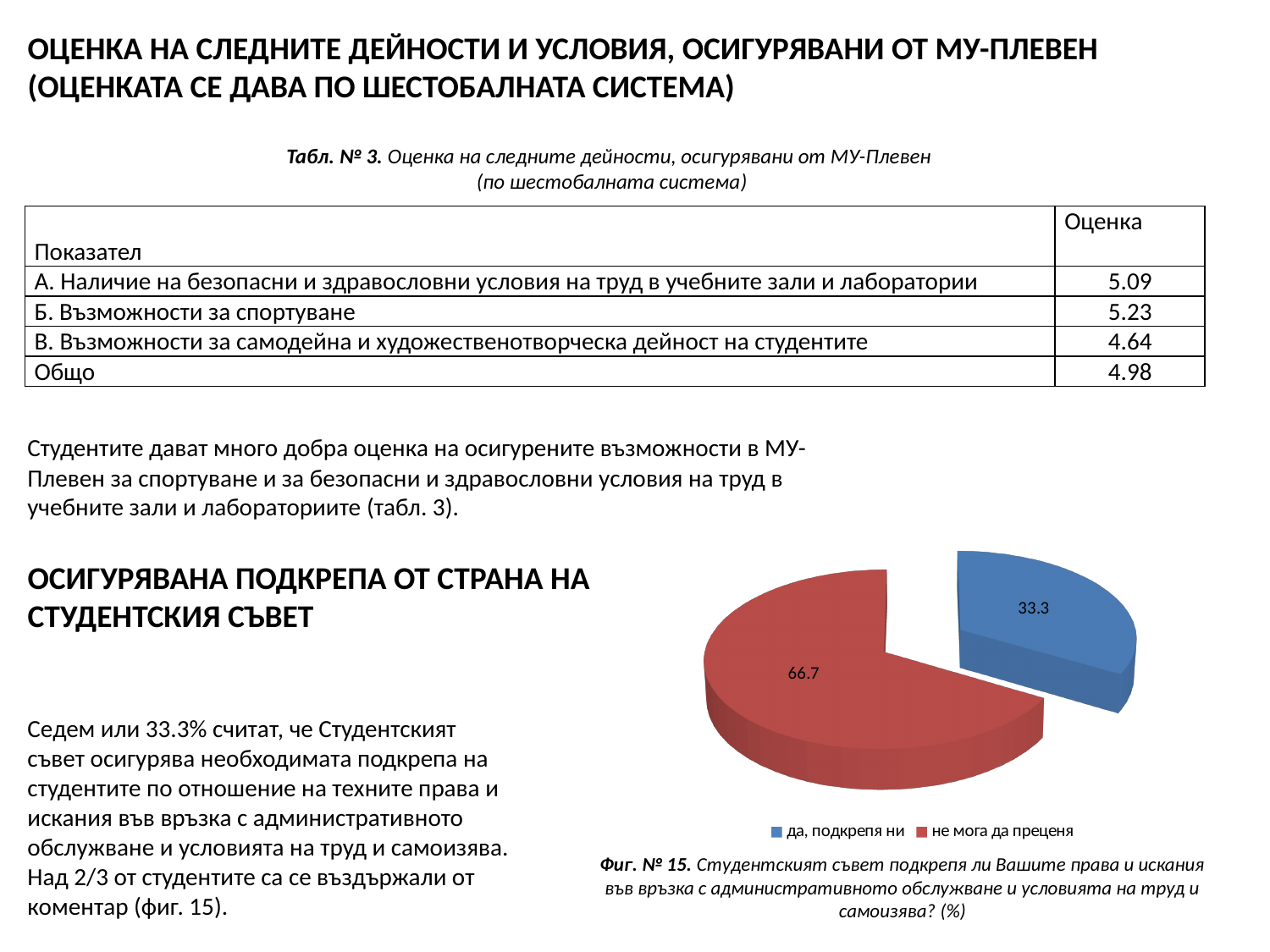
What is the difference between the values for "не мога да преценя" and "да, подкрепя ни" in the pie chart? 33.4 What colour is the "не мога да преценя" slice in the pie chart? red What is the value for "не мога да преценя" in the pie chart? 66.7 How many slices does the pie chart have? 2 Which slice of the pie chart is the largest? не мога да преценя What is the value for "да, подкрепя ни" in the pie chart? 33.3 Which is larger in the pie chart: "да, подкрепя ни" or "не мога да преценя"? не мога да преценя How many entries does the legend of the pie chart list? 2 What colour is the "да, подкрепя ни" slice in the pie chart? blue Which slice of the pie chart is the smallest? да, подкрепя ни What kind of chart is shown on the slide? pie chart